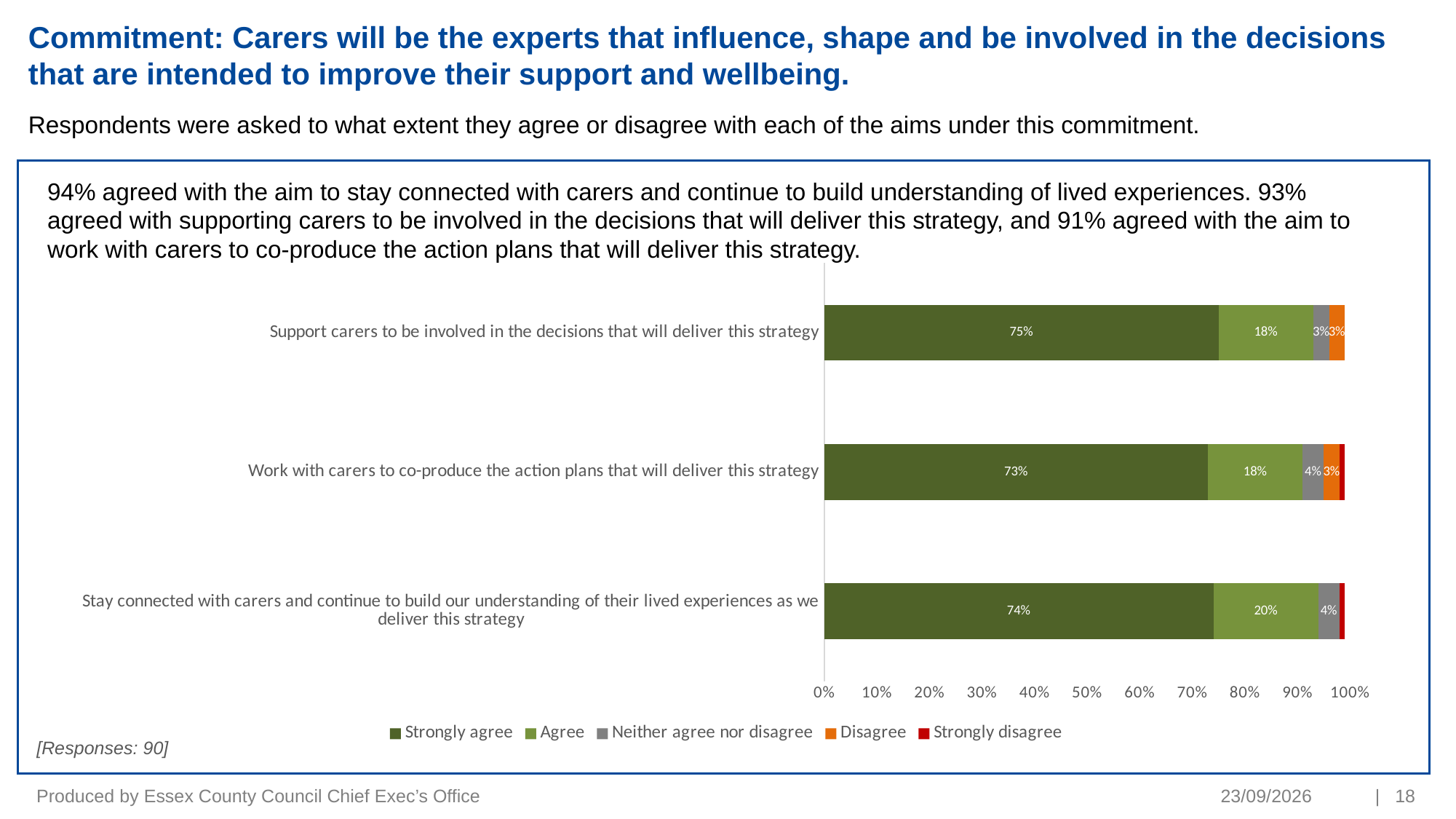
How many series does the legend list? 5 Which aim has the lowest 'Strongly agree' percentage? Work with carers to co-produce the action plans that will deliver this strategy How many responses does the chart note state were received? 90 Which is larger: the 'Agree' value for 'Stay connected with carers' or the 'Agree' value for 'Support carers to be involved in the decisions'? Stay connected with carers What is the 'Agree' value for 'Stay connected with carers and continue to build our understanding of their lived experiences as we deliver this strategy'? 20% What percentage of respondents strongly agreed with 'Support carers to be involved in the decisions that will deliver this strategy'? 75% How many categories (aims) are plotted in the chart? 3 What percentage of respondents strongly agreed with 'Work with carers to co-produce the action plans that will deliver this strategy'? 73% What is the 'Neither agree nor disagree' value for 'Work with carers to co-produce the action plans that will deliver this strategy'? 4% What is the difference between the 'Strongly agree' values for 'Support carers to be involved in the decisions' and 'Work with carers to co-produce the action plans'? 2% Which aim has the highest 'Strongly agree' percentage? Support carers to be involved in the decisions that will deliver this strategy What kind of chart is shown on the slide? Stacked bar chart